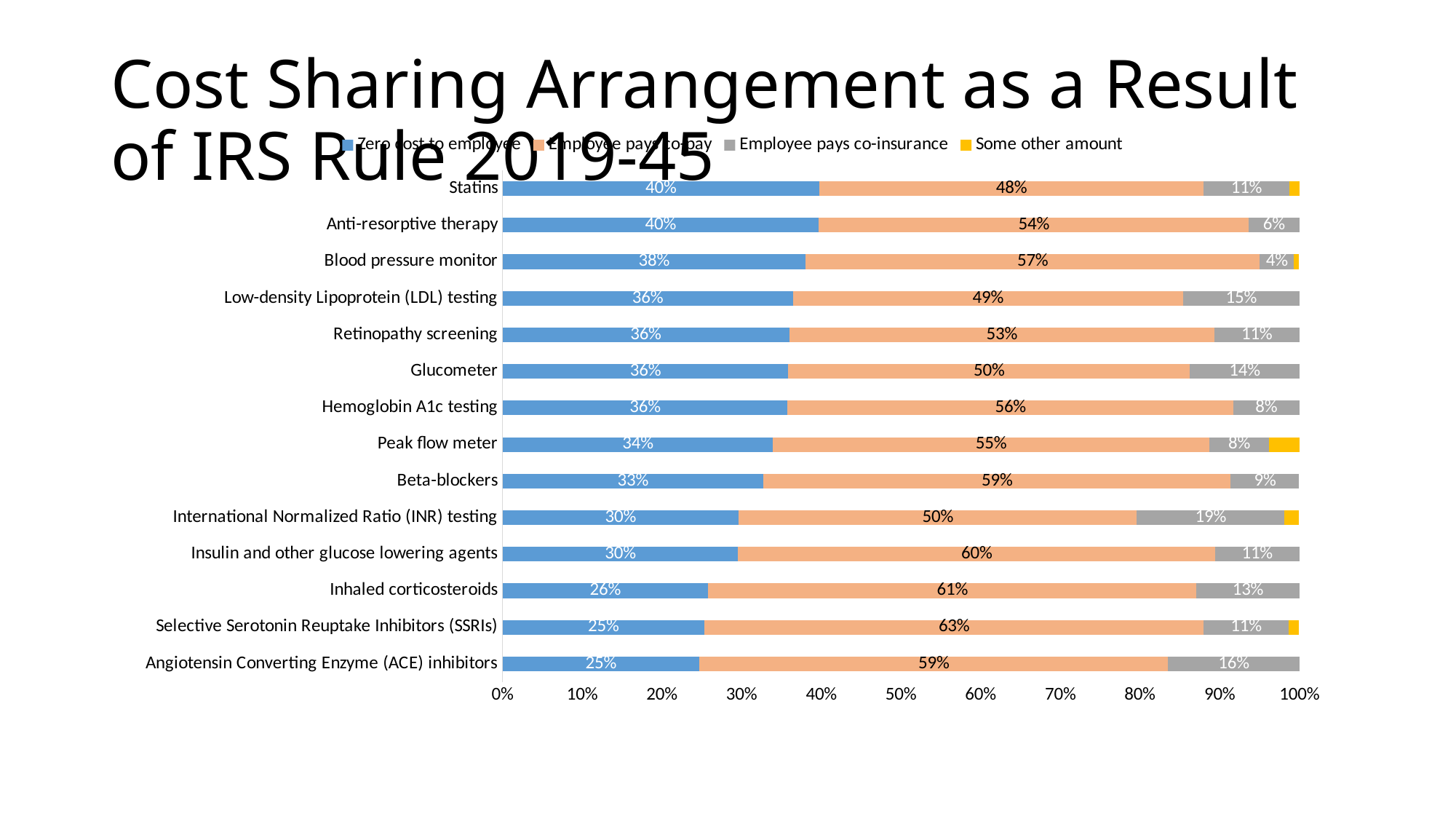
What is the 'Zero cost to employee' value for Inhaled corticosteroids? 26% What is the 'Employee pays co-insurance' value for International Normalized Ratio (INR) testing? 19% What is the 'Employee pays co-pay' value for Blood pressure monitor? 57% Which category has the lowest 'Employee pays co-insurance' value? Blood pressure monitor How many series does the legend list? 4 Is the 'Some other amount' value for Peak flow meter greater or less than 10%? less What percentage of Statins plans have zero cost to employee? 40% How many categories are shown on the chart? 14 What kind of chart is shown on the slide? Stacked bar chart What is the difference in percentage points between the 'Employee pays co-pay' values for Selective Serotonin Reuptake Inhibitors (SSRIs) and Statins? 15 Which has a larger 'Employee pays co-pay' value, Glucometer or Beta-blockers? Beta-blockers Which category has the highest 'Employee pays co-pay' value? Selective Serotonin Reuptake Inhibitors (SSRIs)